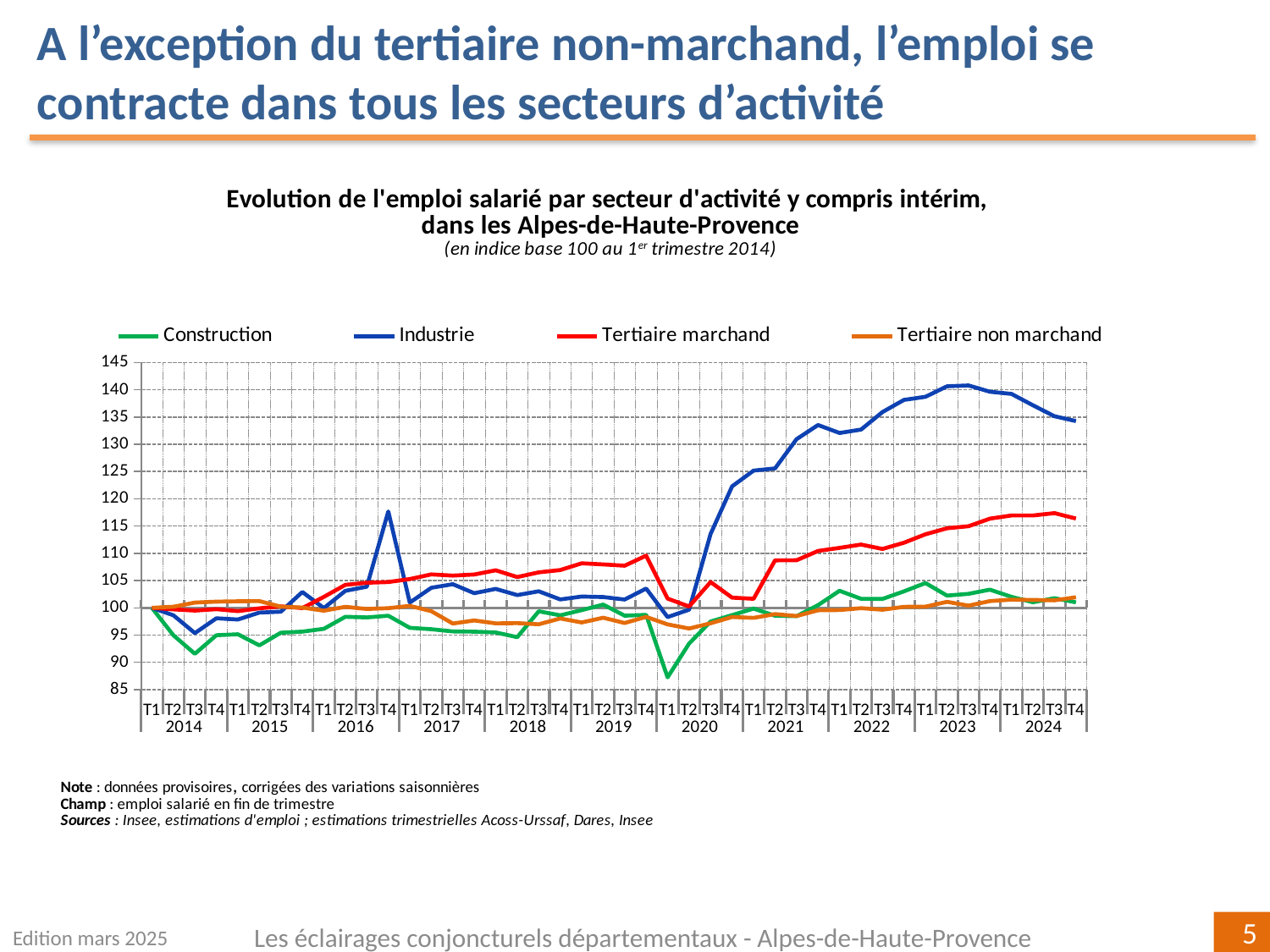
Which series has the lowest value at T1 2020? Construction How many series does the legend list? 4 At T4 2024, which is larger: Tertiaire marchand or Construction? Tertiaire marchand Which colour is used for the Tertiaire non marchand series? orange Is the value for Tertiaire marchand at T4 2024 greater or less than 115? greater Does the Industrie series rise or fall between T1 2020 and T1 2023? rise Is the value for Construction at T1 2020 greater or less than 90? less What kind of chart is shown on the slide? line chart Which series has the highest value at T4 2024? Industrie How many years are shown on the x axis? 11 Is the value for Industrie at T4 2024 greater or less than 130? greater